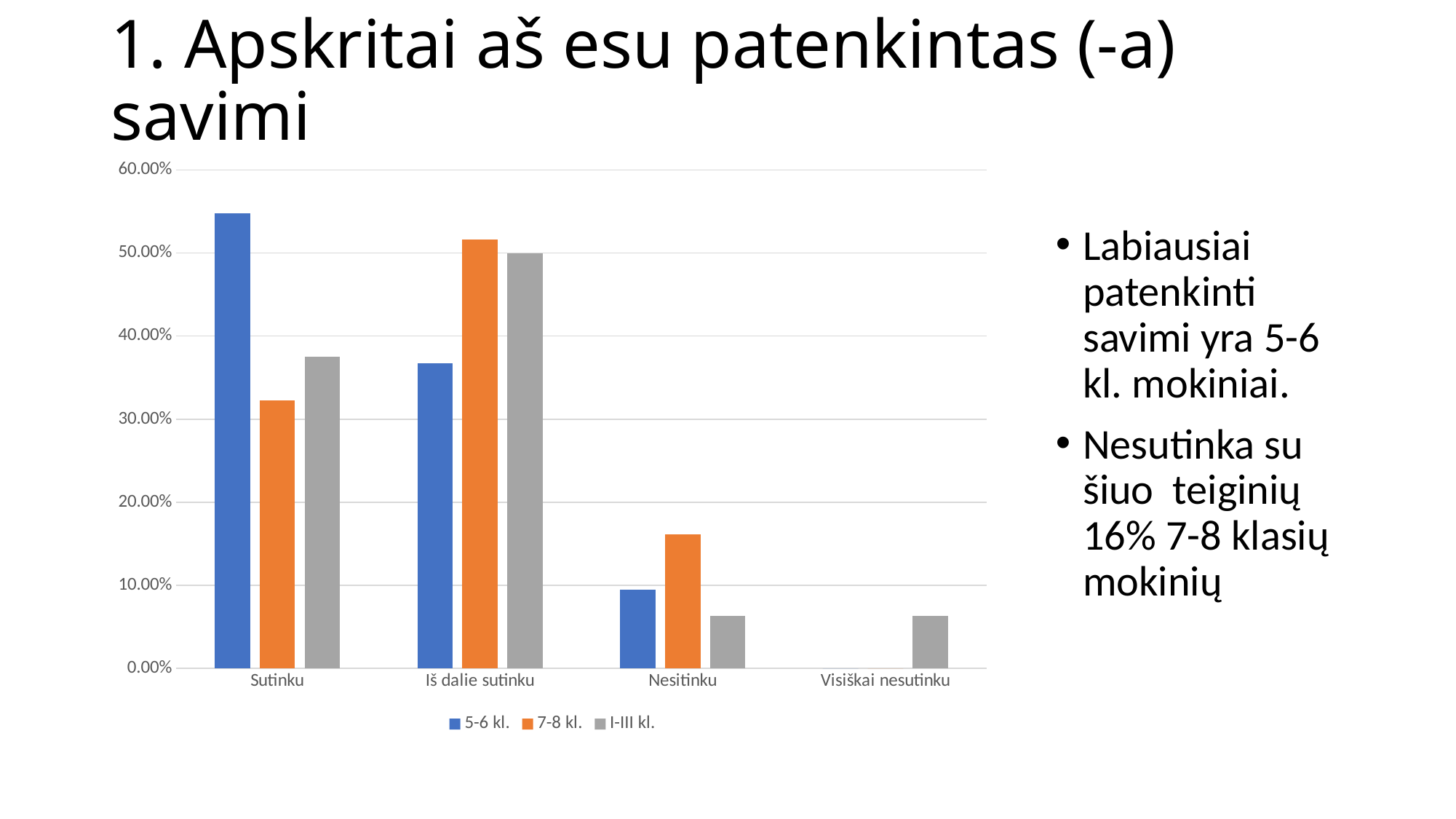
How many categories are shown on the x axis? 4 For the 7-8 kl. series, which category has the highest value? Iš dalie sutinku For the 5-6 kl. series, which category has the highest value? Sutinku For Iš dalie sutinku, which is larger: the 7-8 kl. value or the 5-6 kl. value? 7-8 kl. Which series is shown in orange in the legend? 7-8 kl. How many series does the legend list? 3 What kind of chart is shown on the slide? bar chart Which series has the highest value for Nesitinku? 7-8 kl. Is the value for I-III kl. at Nesitinku greater or less than 10.00%? less Which series has the lowest value for Sutinku? 7-8 kl. Is the value for 5-6 kl. at Sutinku greater or less than 50.00%? greater